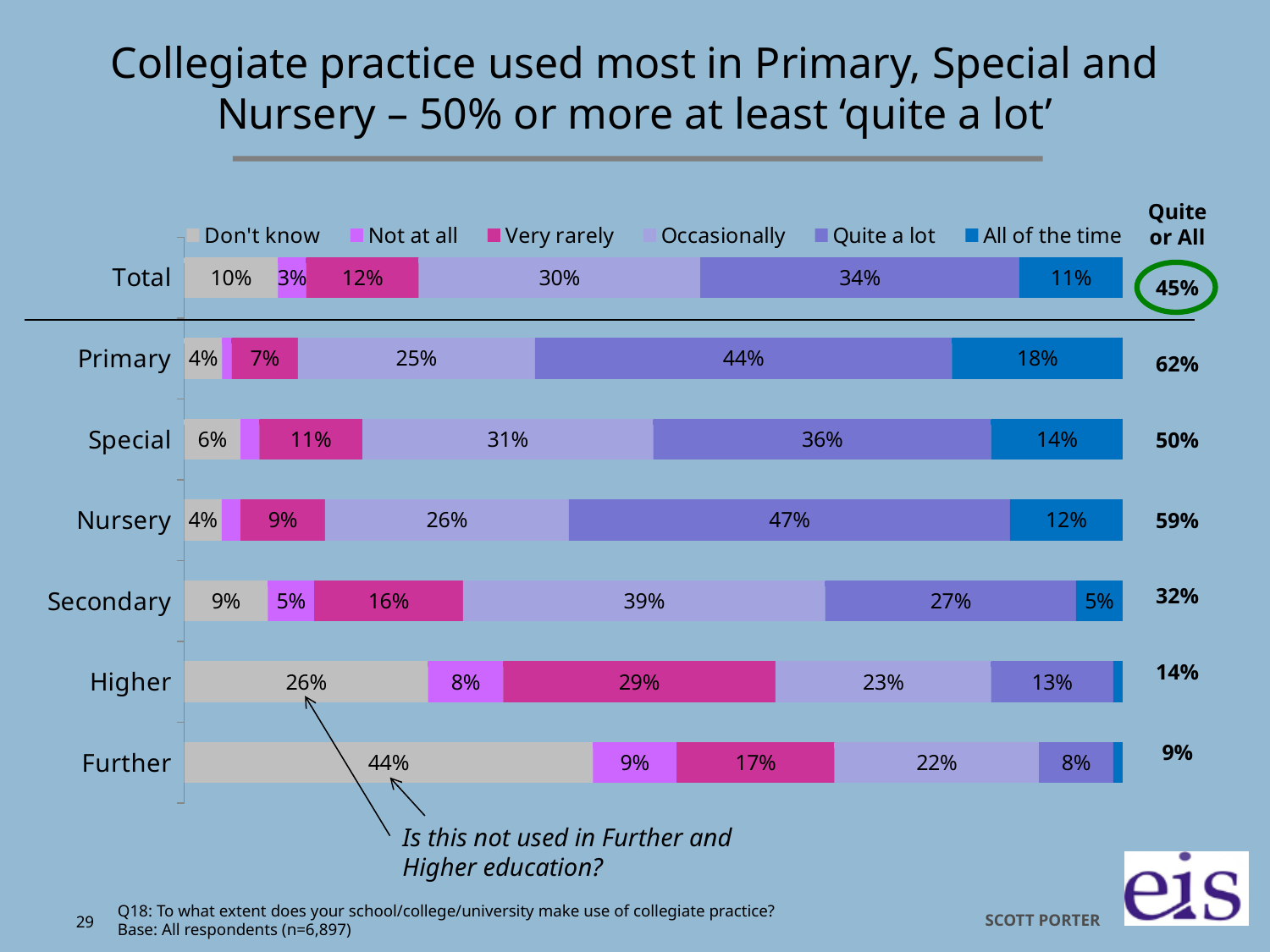
Which category has the highest 'Quite a lot' value? Nursery What is the difference between the 'Quite a lot' values for Primary and Secondary? 17 percentage points What is the 'Occasionally' value for Total? 30% Which category has the lowest 'Quite a lot' value? Further What is the 'Don't know' value for Further? 44% What percentage of Primary respondents answered 'Quite a lot'? 44% What is the 'Very rarely' value for Secondary? 16% What kind of chart is shown on the slide? Stacked bar chart Which is larger, the 'Occasionally' value for Special or for Nursery? Special How many categories (bars) are shown in the chart? 7 How many series does the legend list? 6 What 'Quite or All' value is shown for Total in the column to the right of the chart? 45%